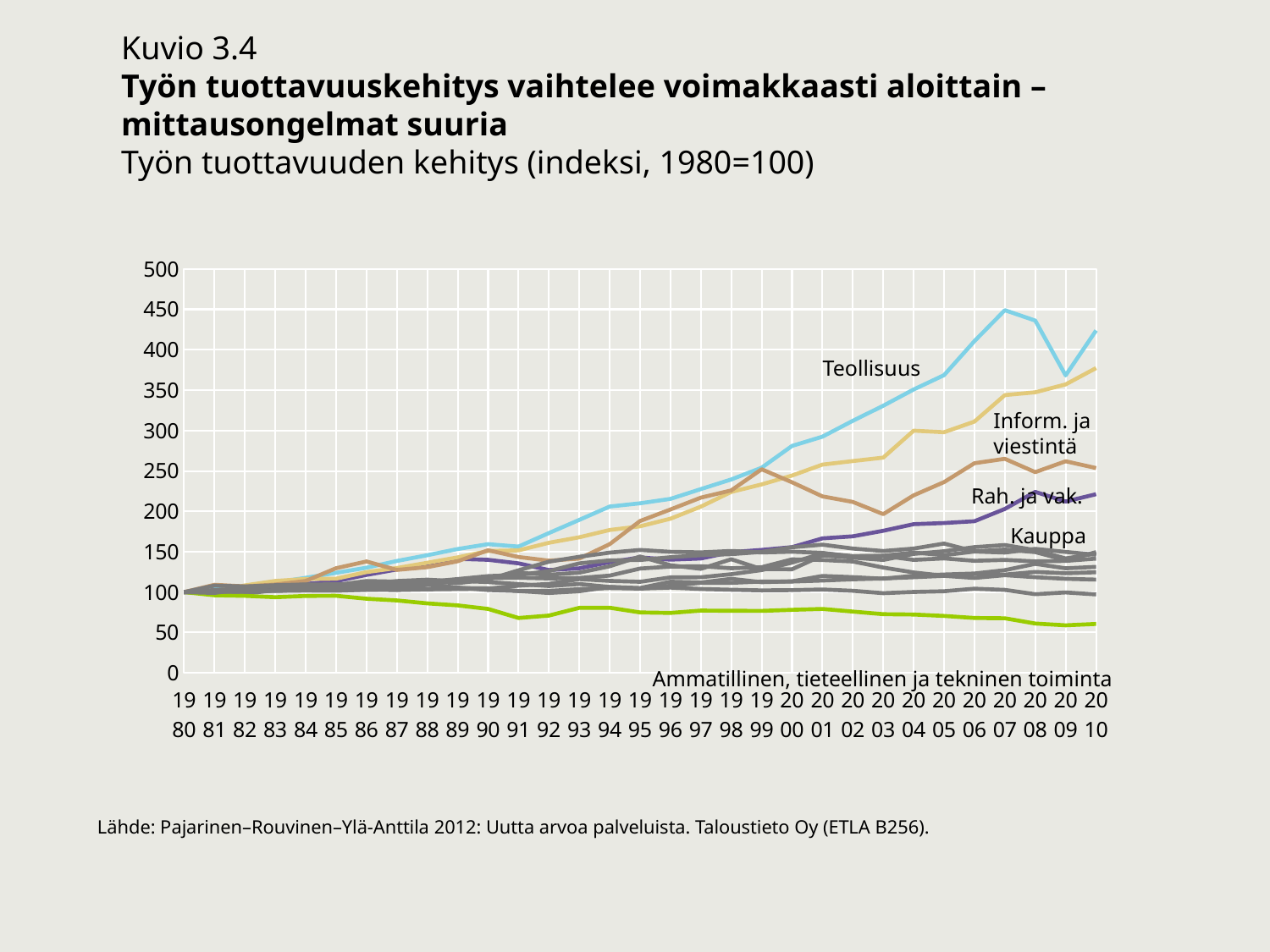
What is the base year and value of the index used in the chart? 1980=100 Does the Ammatillinen, tieteellinen ja tekninen toiminta line rise or fall overall from 1980 to 2010? fall In 2010, which is higher: Teollisuus or Inform. ja viestintä? Teollisuus Is the value for Teollisuus in 2000 greater or less than 250? greater Which labelled series has the lowest value in 2010? Ammatillinen, tieteellinen ja tekninen toiminta How many years are shown on the x axis of the chart? 31 Is the value for Teollisuus in 2009 greater or less than 400? less Is the value for Inform. ja viestintä in 2010 greater or less than 200? greater Does the Teollisuus line rise or fall overall from 1980 to 2010? rise What kind of chart is shown on the slide? line chart